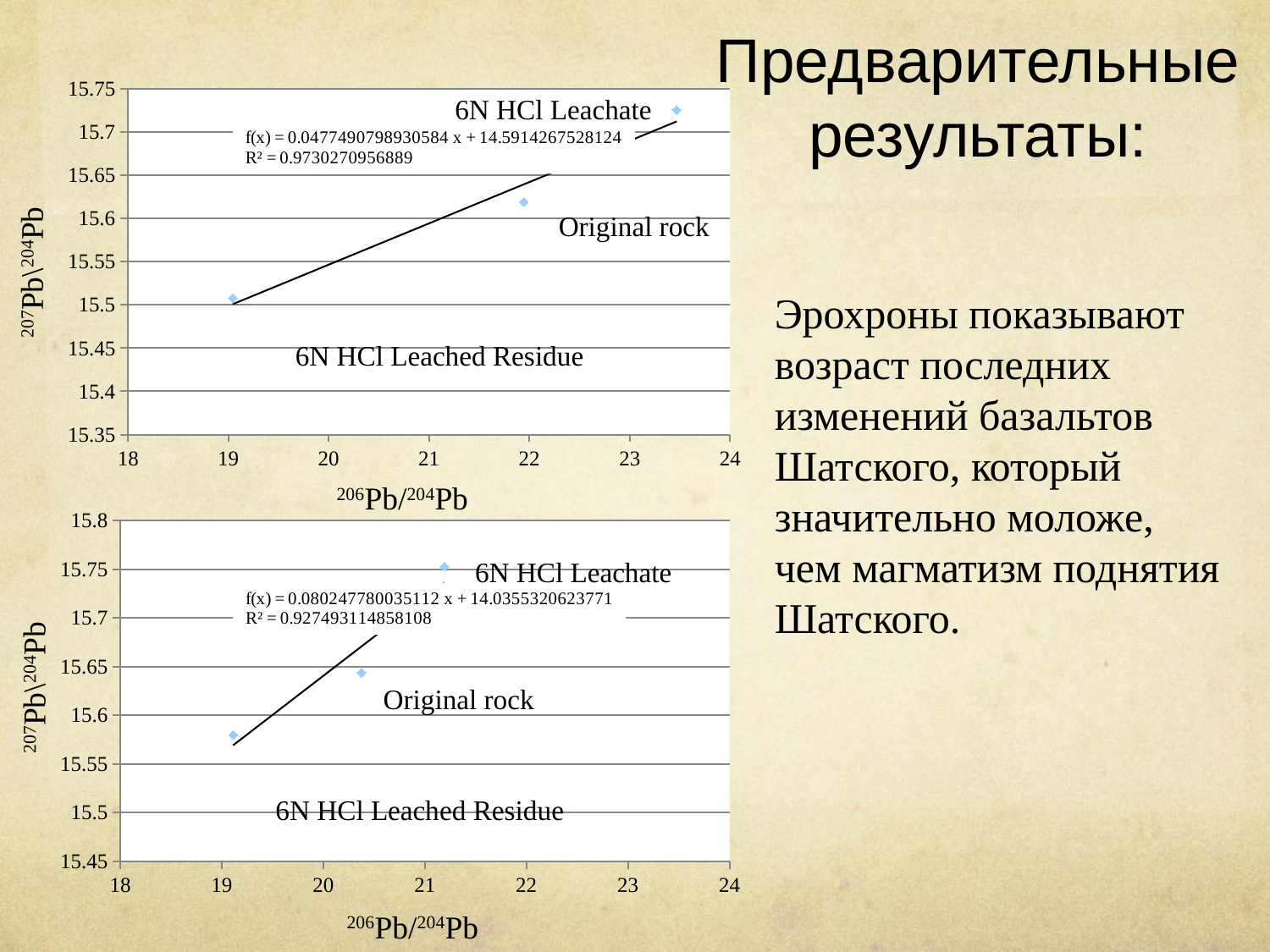
In the bottom chart, is the 207Pb/204Pb value for 6N HCl Leached Residue greater or less than 15.6? less In the bottom chart, which labelled point has the lowest 207Pb/204Pb value? 6N HCl Leached Residue In the top chart, do the 207Pb/204Pb values rise or fall as 206Pb/204Pb increases? rise In the top chart, which labelled point has the highest 207Pb/204Pb value? 6N HCl Leachate What kind of chart is the top chart on the slide? scatter chart In the bottom chart, which has the higher 207Pb/204Pb value, Original rock or 6N HCl Leachate? 6N HCl Leachate In the top chart, which labelled point has the lowest 207Pb/204Pb value? 6N HCl Leached Residue How many data points are plotted in the top chart? 3 How many data points are plotted in the bottom chart? 3 What R² value is printed on the bottom chart? 0.927493114858108 What R² value is printed on the top chart? 0.9730270956889 In the top chart, is the 207Pb/204Pb value for Original rock greater or less than 15.6? greater